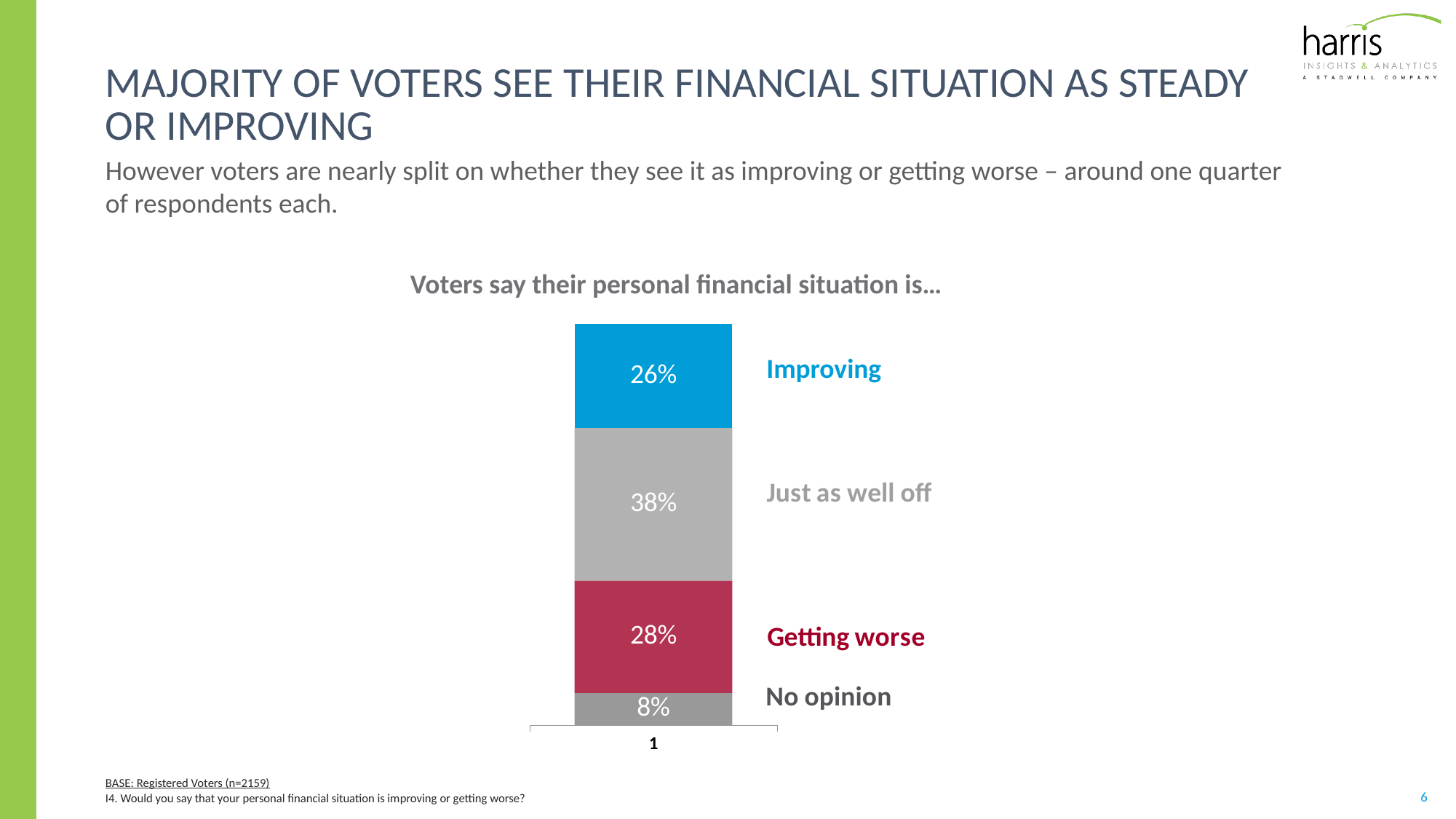
What percentage of voters say their personal financial situation is just as well off? 38% What is the title of the chart? Voters say their personal financial situation is... What kind of chart is shown on the slide? Stacked bar chart Which response has the largest share of voters? Just as well off What percentage of voters say their personal financial situation is getting worse? 28% Which response has the smallest share of voters? No opinion What is the difference in percentage points between 'Getting worse' and 'Improving'? 2 What percentage of voters say their personal financial situation is improving? 26% Which is larger, the share saying 'Getting worse' or the share saying 'Improving'? Getting worse What is the difference in percentage points between 'Just as well off' and 'No opinion'? 30 What percentage of voters have no opinion on their personal financial situation? 8% How many response categories are shown in the stacked bar? 4